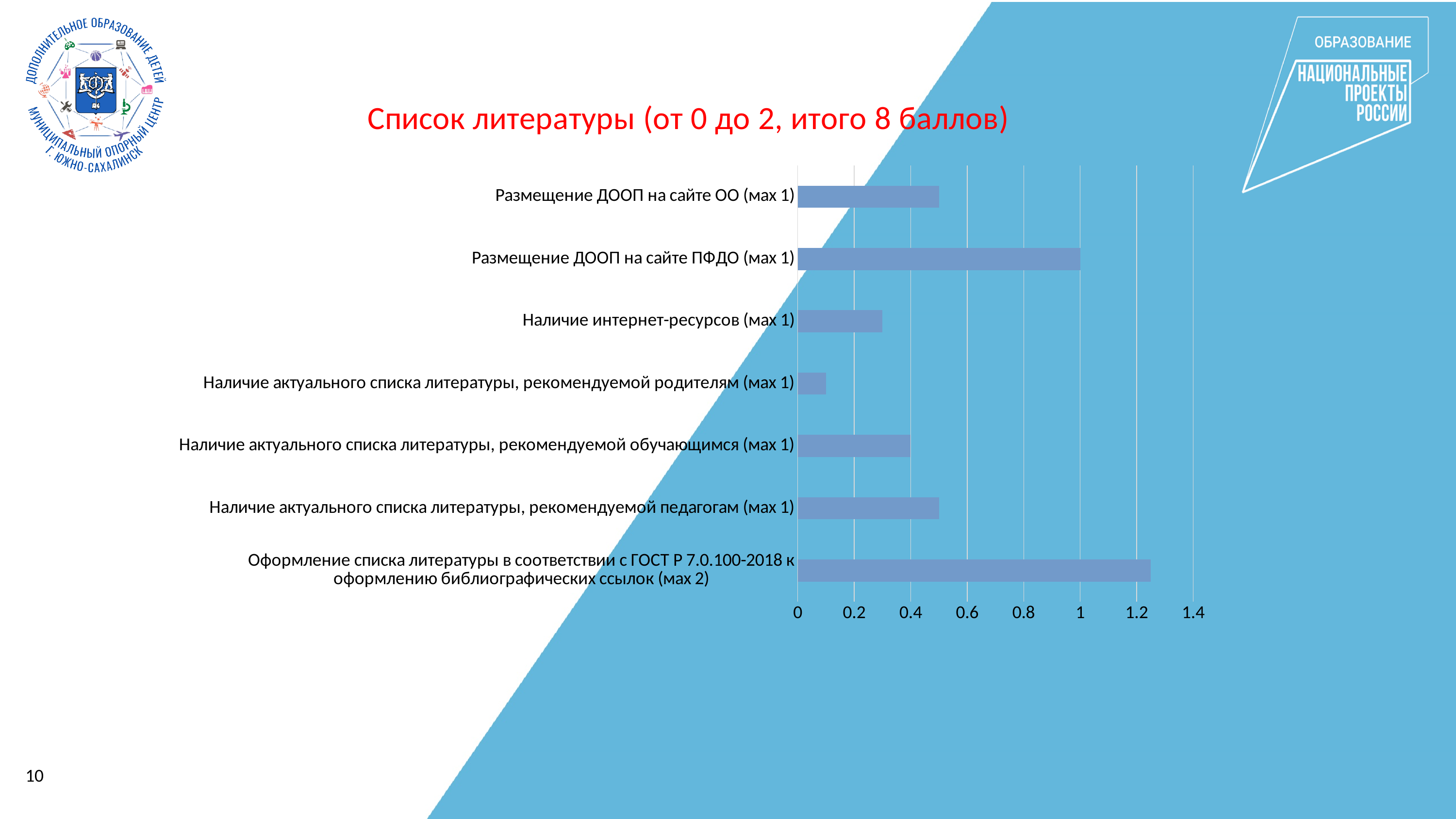
Which category has the highest value? Оформление списка литературы в соответствии с ГОСТ Р 7.0.100-2018 к оформлению библиографических ссылок (max 2) Which is larger: the value for "Размещение ДООП на сайте ПФДО (max 1)" or for "Наличие интернет-ресурсов (max 1)"? Размещение ДООП на сайте ПФДО (max 1) What kind of chart is shown on the slide? bar chart Is the value for "Наличие актуального списка литературы, рекомендуемой родителям (max 1)" greater or less than 0.2? less Which category has the lowest value? Наличие актуального списка литературы, рекомендуемой родителям (max 1) Which is larger: the value for "Наличие актуального списка литературы, рекомендуемой педагогам (max 1)" or for "Наличие актуального списка литературы, рекомендуемой родителям (max 1)"? Наличие актуального списка литературы, рекомендуемой педагогам (max 1) Is the value for "Размещение ДООП на сайте ОО (max 1)" greater or less than 0.4? greater How many categories are plotted in the chart? 7 What is the value for "Размещение ДООП на сайте ПФДО (max 1)"? 1 What is the title of the chart slide? Список литературы (от 0 до 2, итого 8 баллов) Is the value for "Оформление списка литературы в соответствии с ГОСТ Р 7.0.100-2018 к оформлению библиографических ссылок (max 2)" greater or less than 1.2? greater